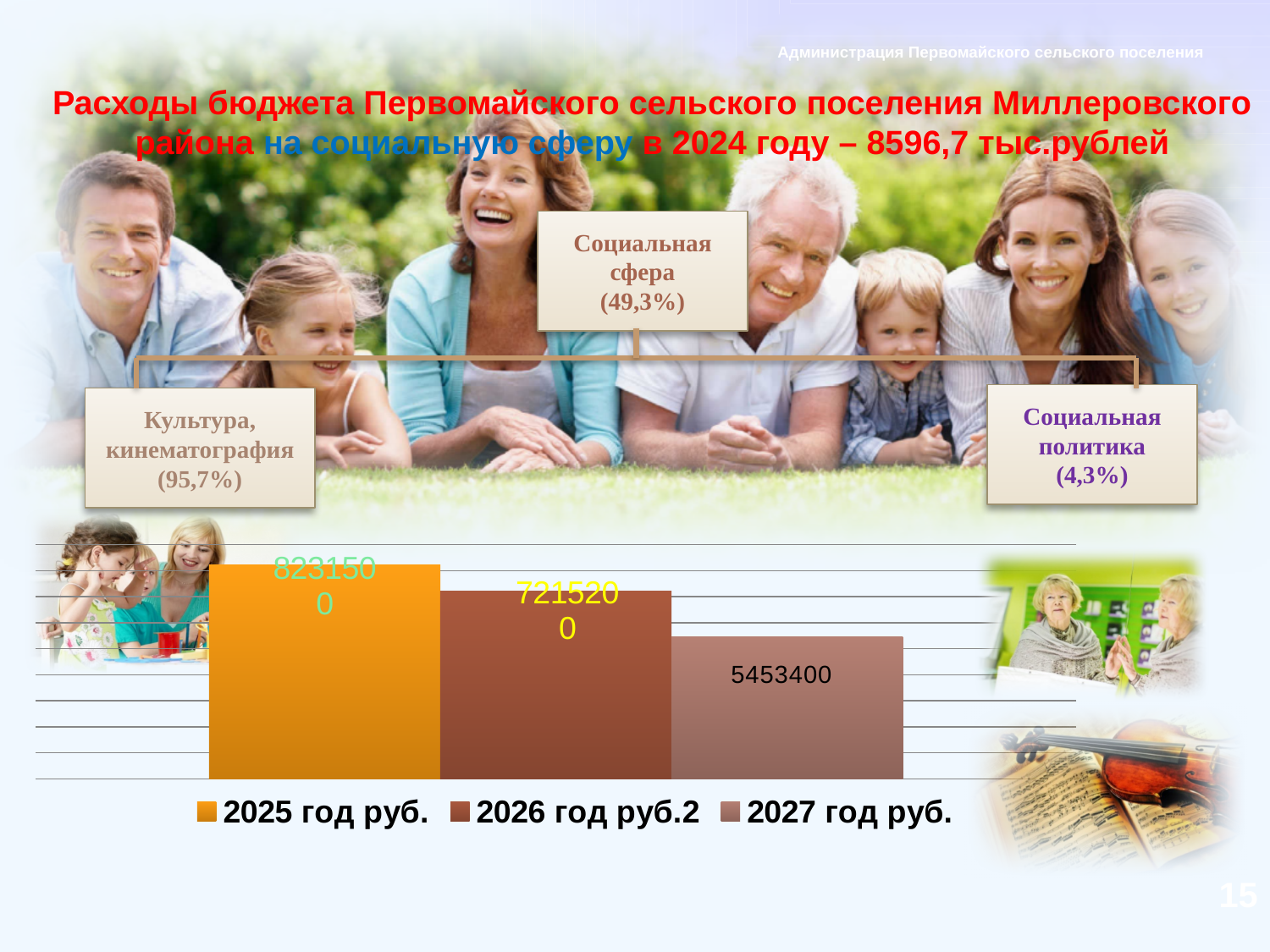
What is the value shown for the series "2025 год руб." in the bar chart? 8231500 What is the difference between the values for "2025 год руб." and "2026 год руб.2"? 1016300 How many series does the chart legend list? 3 Do the values rise or fall from the 2025 bar to the 2027 bar? fall What kind of chart is shown on the slide? bar chart Which series has the highest value in the bar chart? 2025 год руб. What is the difference between the values for "2026 год руб.2" and "2027 год руб."? 1761800 How many bars are plotted in the chart? 3 Which series has the lowest value in the bar chart? 2027 год руб. What is the value shown for the series "2027 год руб." in the bar chart? 5453400 Which is larger: the value for "2025 год руб." or the value for "2027 год руб."? 2025 год руб. What is the value shown for the series "2026 год руб.2" in the bar chart? 7215200